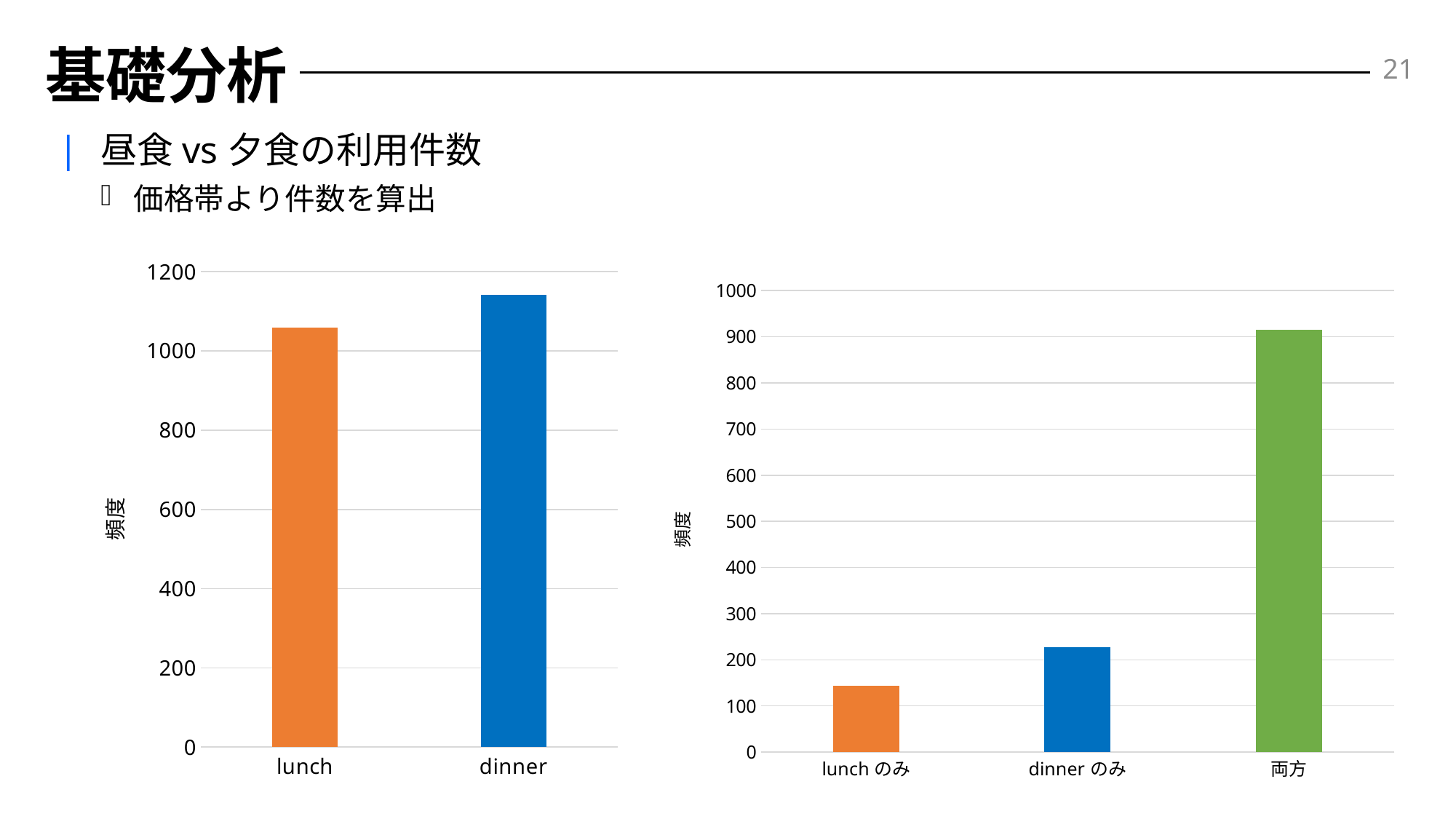
In the right chart, is the value for 両方 greater or less than 900? greater In the right chart, how many categories are plotted? 3 In the right chart, which category has the highest value? 両方 In the right chart, which is larger, lunch のみ or dinner のみ? dinner のみ In the right chart, which category has the lowest value? lunch のみ In the left chart, what kind of chart is shown? bar chart In the left chart, which category has the higher value, lunch or dinner? dinner In the right chart, is the value for dinner のみ greater or less than 300? less In the right chart, what is the label on the vertical axis? 頻度 In the left chart, is the value for lunch greater or less than 1000? greater In the left chart, how many categories are plotted? 2